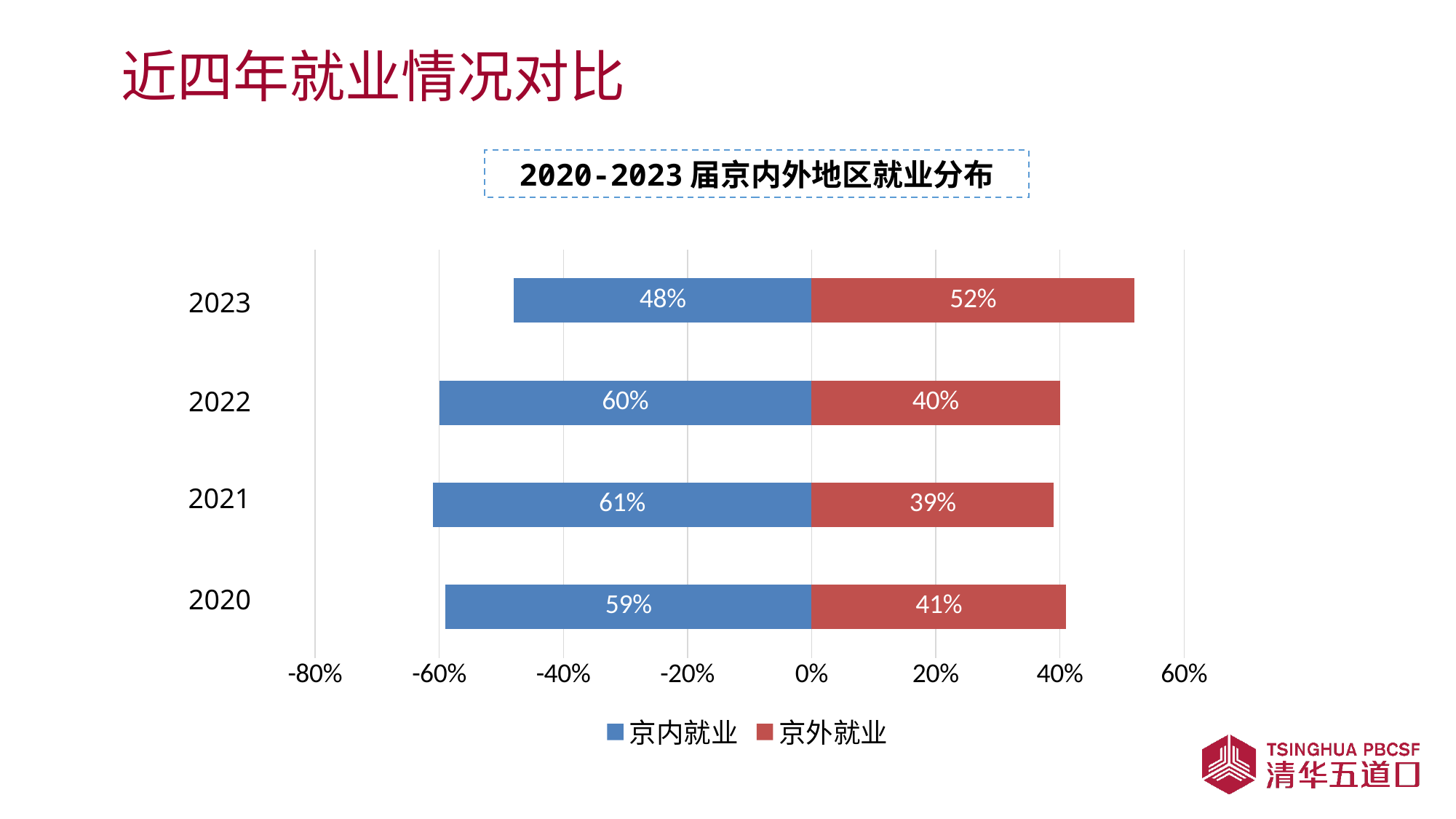
How many series does the legend list? 2 What is the value for 京内就业 in 2023? 48% What is the value for 京外就业 in 2022? 40% What is the value for 京内就业 in 2021? 61% What is the difference between 京内就业 and 京外就业 in 2022? 20% Which year has the highest value for 京外就业? 2023 In 2023, which is larger, 京内就业 or 京外就业? 京外就业 How many years are shown on the chart? 4 Which year has the lowest value for 京内就业? 2023 What is the value for 京外就业 in 2020? 41% What kind of chart is shown on the slide? Bar chart What is the title of the chart? 2020-2023 届京内外地区就业分布